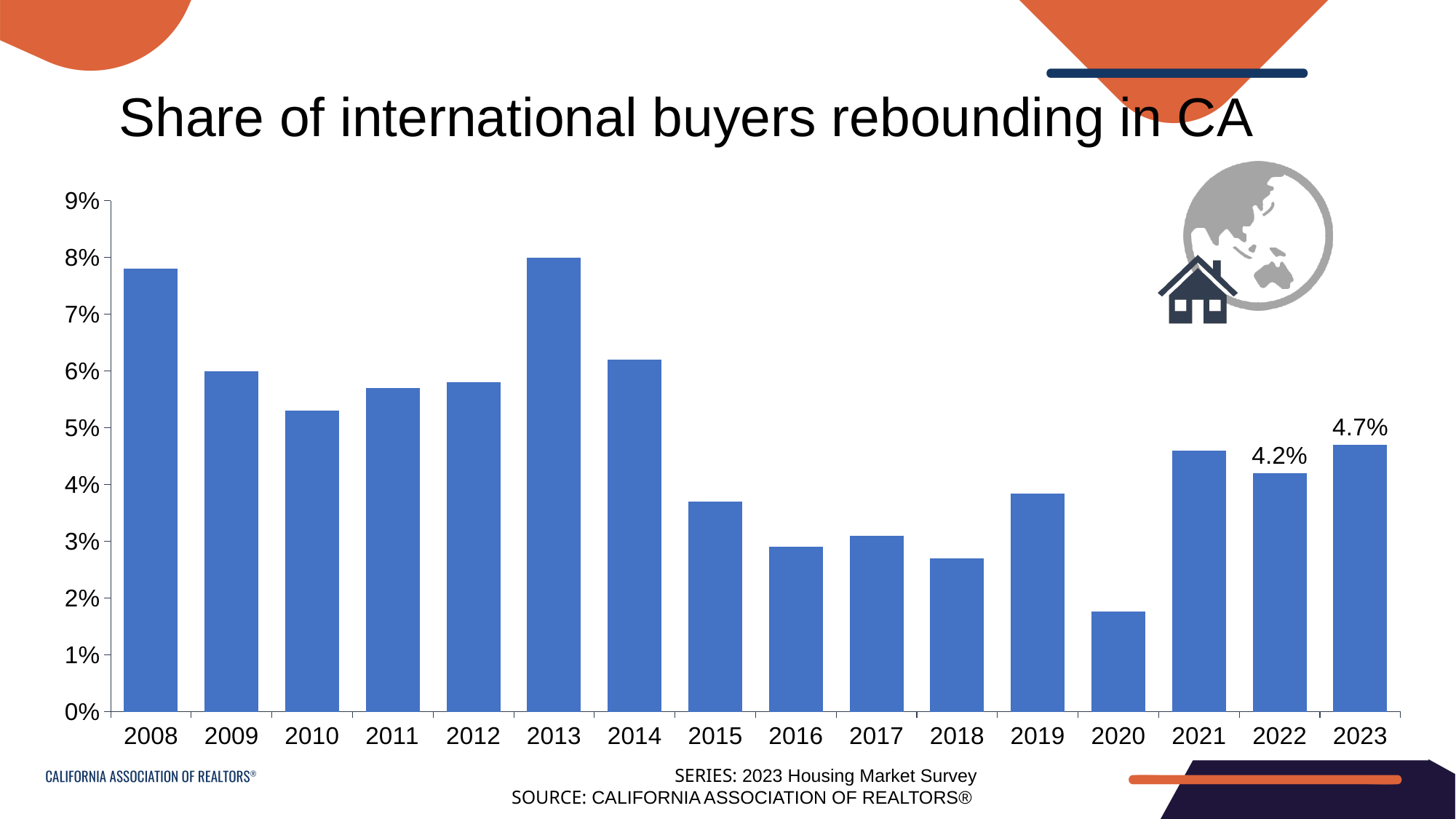
What is the share of international buyers in 2022? 4.2% Do the values rise or fall from 2020 to 2023? Rise Is the value for 2010 greater or less than 5%? greater Is the value for 2020 greater or less than 2%? less By how much did the share of international buyers change from 2022 to 2023? 0.5% Which year has a larger share of international buyers, 2008 or 2009? 2008 Which year has the lowest share of international buyers? 2020 What is the share of international buyers in 2023? 4.7% How many years are shown on the x axis? 16 What kind of chart is shown on the slide? Bar chart Which year has the highest share of international buyers? 2013